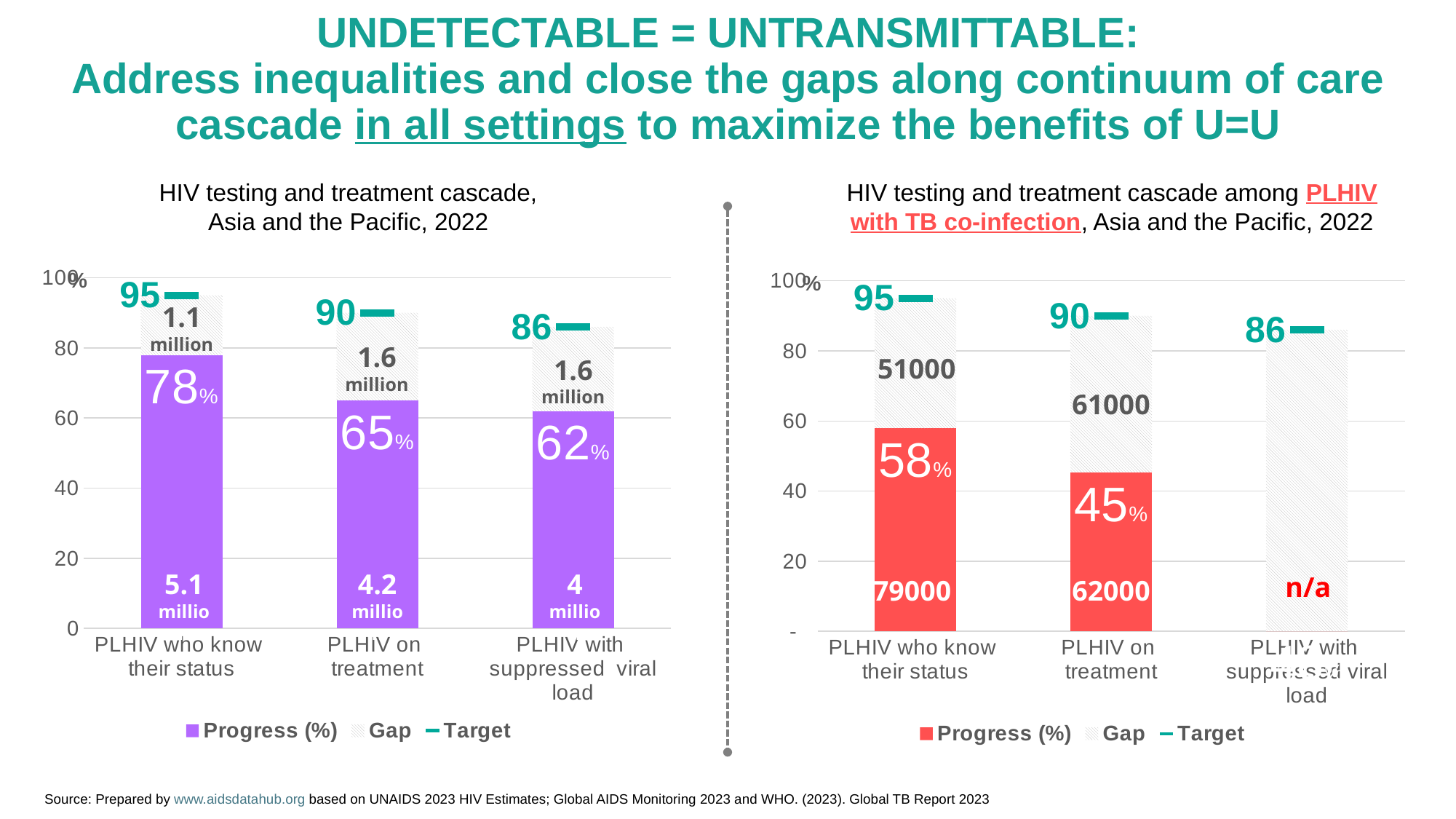
In the right chart (cascade among PLHIV with TB co-infection), what is the progress percentage for PLHIV on treatment? 45% In the left chart (HIV testing and treatment cascade, Asia and the Pacific, 2022), what is the progress percentage for PLHIV who know their status? 78% In the left chart (HIV testing and treatment cascade, Asia and the Pacific, 2022), which category has the lowest progress percentage? PLHIV with suppressed viral load What type of chart is the left chart (HIV testing and treatment cascade, Asia and the Pacific, 2022)? Bar chart How many series does the legend of the right chart (cascade among PLHIV with TB co-infection) list? 3 In the right chart (cascade among PLHIV with TB co-infection), what is the progress value shown for PLHIV with suppressed viral load? n/a In the right chart (cascade among PLHIV with TB co-infection), what is the difference in progress percentage between PLHIV who know their status and PLHIV on treatment? 13 percentage points In the left chart (HIV testing and treatment cascade, Asia and the Pacific, 2022), what is the progress percentage for PLHIV with suppressed viral load? 62% In the left chart (HIV testing and treatment cascade, Asia and the Pacific, 2022), what is the target value shown for PLHIV on treatment? 90 In the right chart (cascade among PLHIV with TB co-infection), what is the gap value labelled for PLHIV on treatment? 61000 How many categories are shown on the x axis of the left chart (HIV testing and treatment cascade, Asia and the Pacific, 2022)? 3 Which is larger: the progress percentage for PLHIV who know their status in the left chart or in the right chart? Left chart (78%)